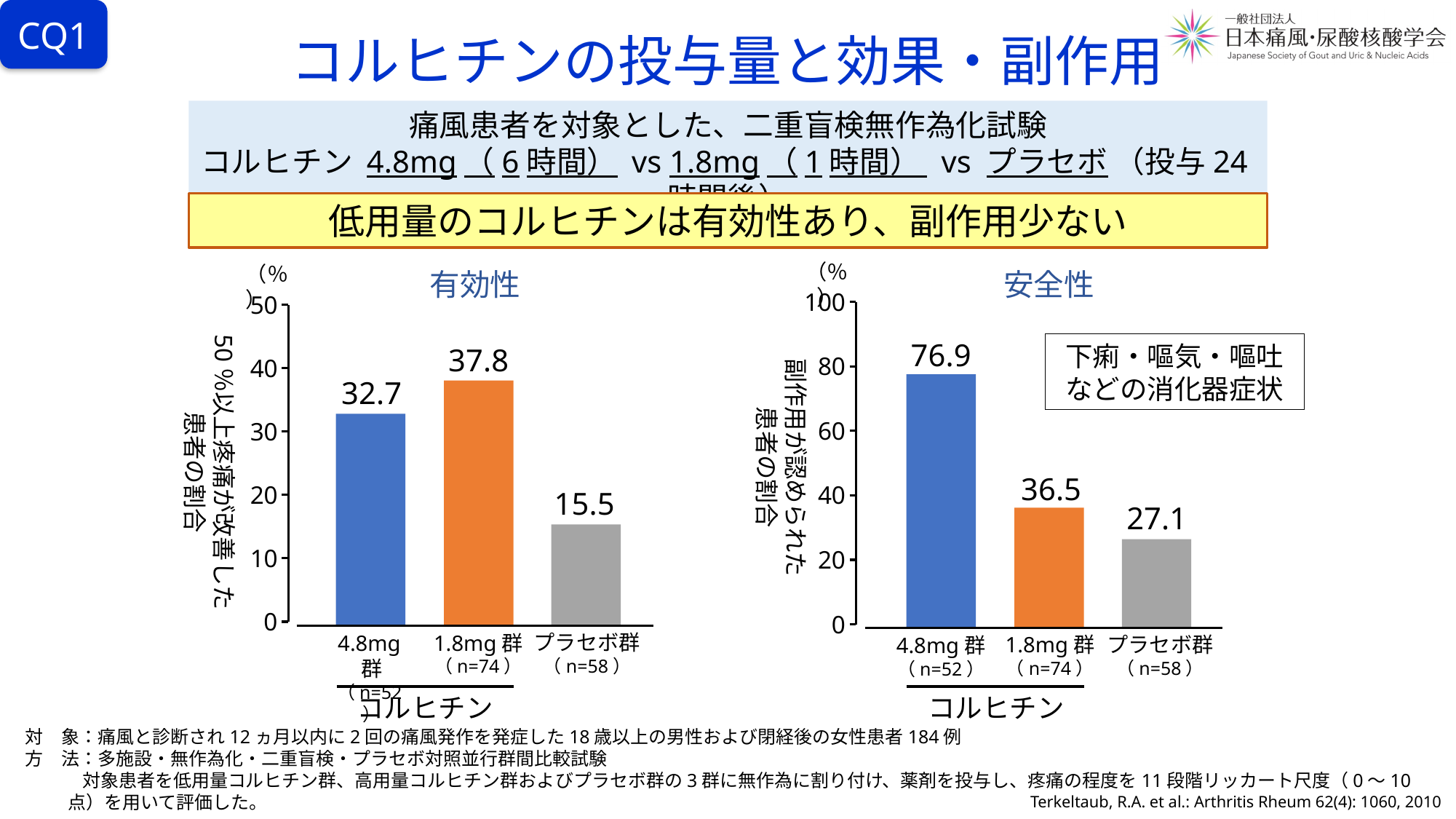
In the 安全性 chart, what is the difference between the 4.8mg群 and the 1.8mg群? 40.4 In the 安全性 chart, what is the value for the 1.8mg群? 36.5 In the 安全性 chart, which group has the lowest value? プラセボ群 In the 有効性 chart, what is the difference between the 1.8mg群 and the プラセボ群? 22.3 In the 安全性 chart, what is the value for the 4.8mg群? 76.9 In the 有効性 chart, what is the value for the プラセボ群? 15.5 In the 有効性 chart, which group has the highest value? 1.8mg群 How many bars are in the 安全性 chart? 3 In the 安全性 chart, what is the maximum value shown on the y axis? 100 What type of chart is the 有効性 chart? Bar chart In the 有効性 chart, what is the value for the 1.8mg群? 37.8 In the 有効性 chart, which is larger, the 4.8mg群 or the 1.8mg群? 1.8mg群